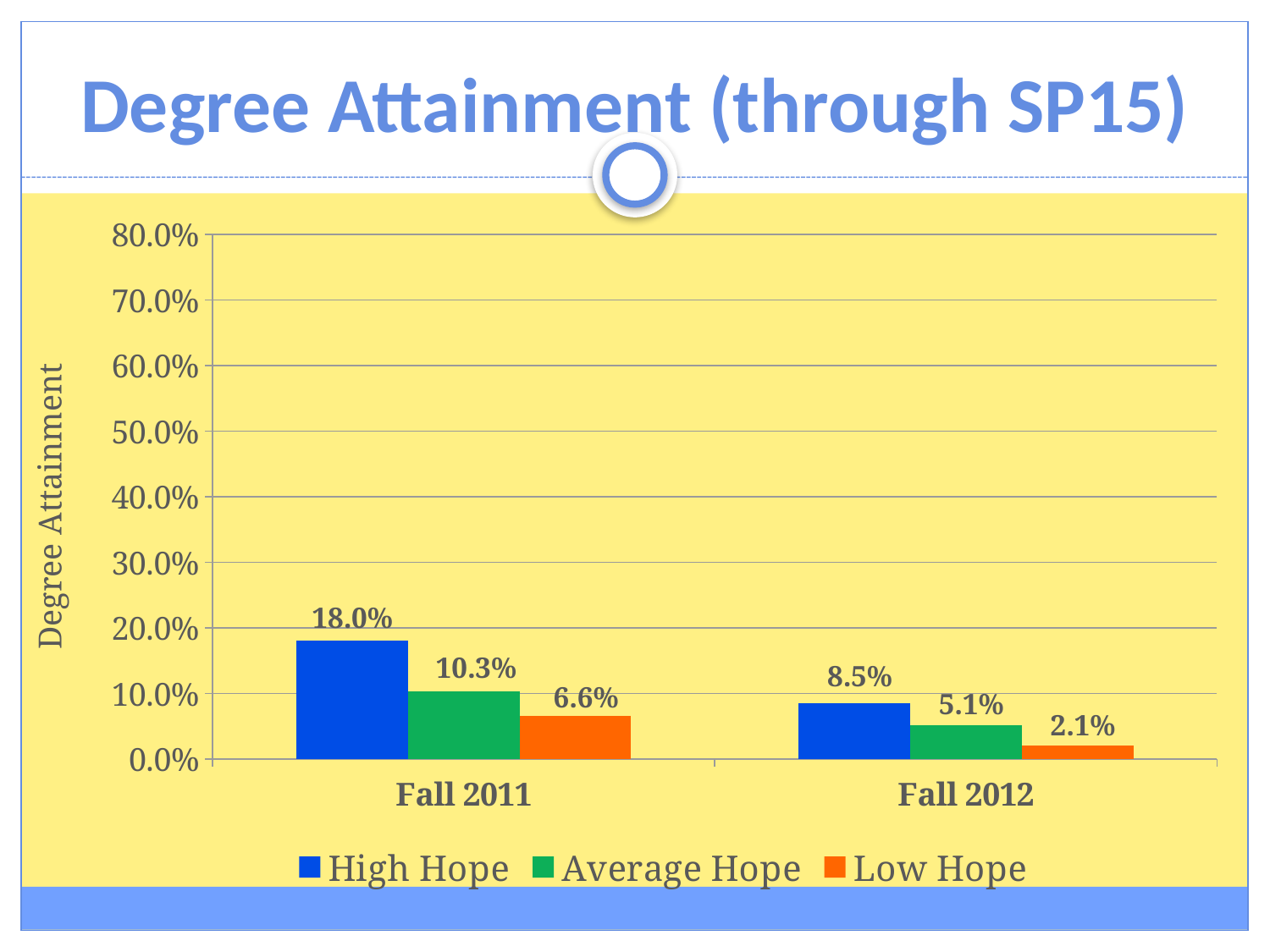
What kind of chart is shown on the slide? Bar chart How many series does the legend list? 3 Which series has the lowest degree attainment in Fall 2012? Low Hope Is the value for High Hope in Fall 2011 greater or less than 20.0%? less What is the degree attainment for Low Hope in Fall 2012? 2.1% Which series has the highest degree attainment in Fall 2011? High Hope What is the difference between High Hope and Low Hope degree attainment in Fall 2011? 11.4% Does the High Hope degree attainment rise or fall from Fall 2011 to Fall 2012? Fall Which is larger: Average Hope in Fall 2011 or High Hope in Fall 2012? Average Hope in Fall 2011 What is the degree attainment for High Hope in Fall 2011? 18.0% What is the degree attainment for Average Hope in Fall 2012? 5.1% What is the difference between High Hope degree attainment in Fall 2011 and Fall 2012? 9.5%